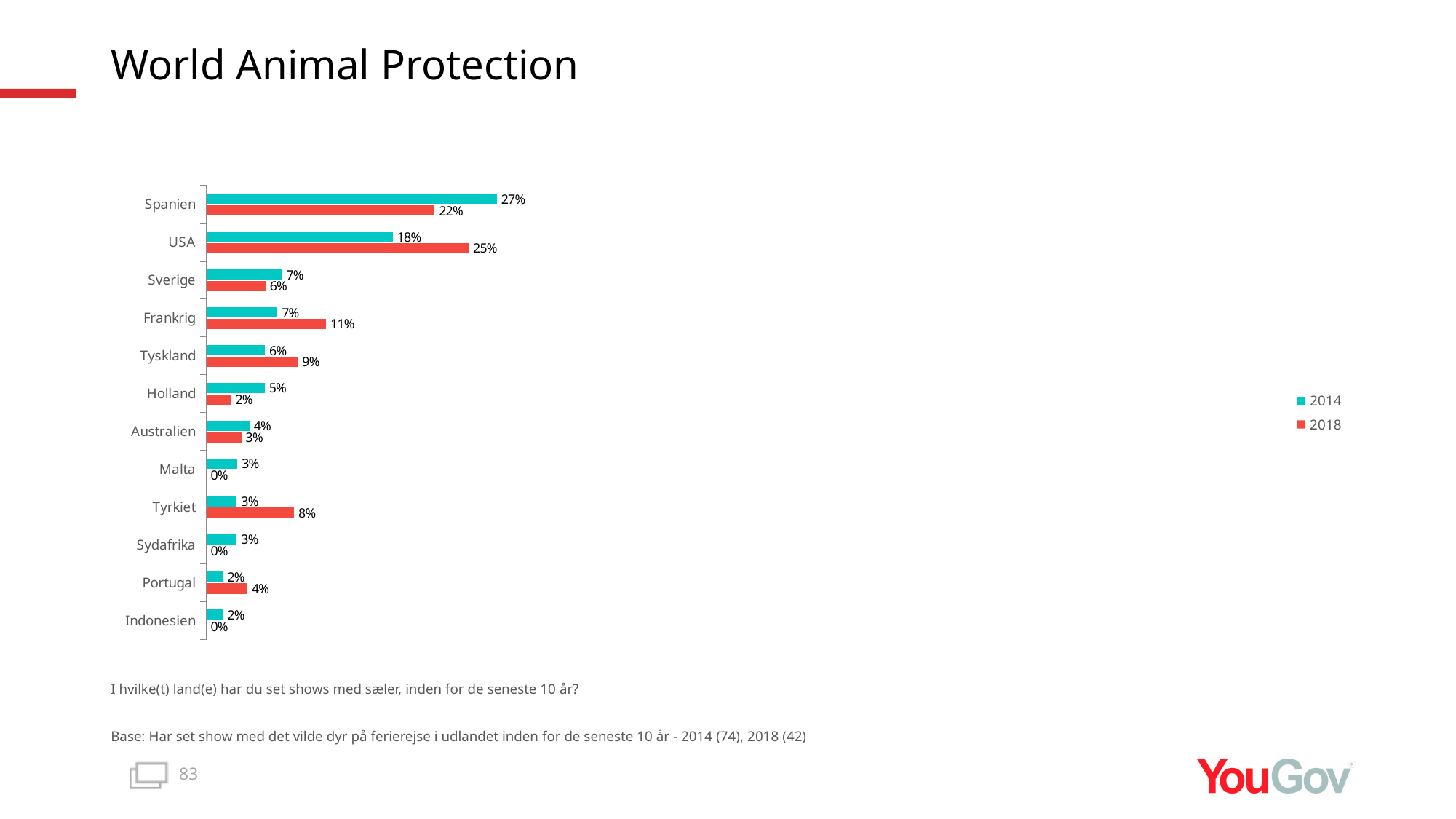
Which is larger for Tyskland, the 2014 value or the 2018 value? 2018 What is the difference between the 2014 and 2018 values for Tyrkiet? 5% Which country has the highest 2018 value? USA What is the difference between the 2014 values for Spanien and USA? 9% Which colour represents the 2018 series in the legend? Red What is the 2018 value for USA? 25% What kind of chart is shown on the slide? Bar chart What is the 2018 value for Frankrig? 11% Which country has the highest 2014 value? Spanien What is the 2014 value for Spanien? 27% How many series does the legend list? 2 How many countries are shown on the chart? 12